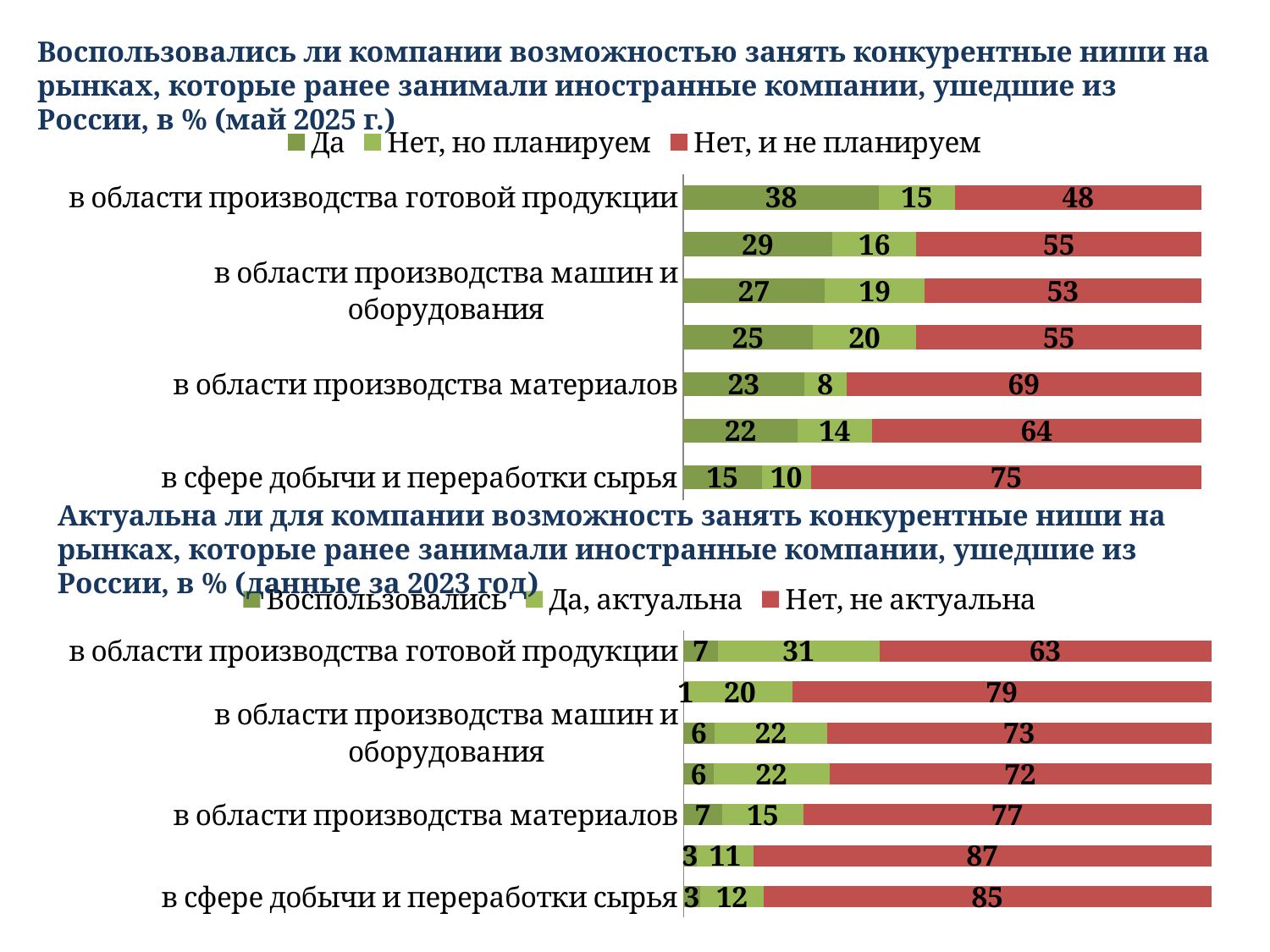
In the top chart (май 2025 г.), what is the value of "Нет, но планируем" for "в области производства материалов"? 8 In the top chart (май 2025 г.), what is the total of the stacked bar for "в области производства материалов"? 100 How many series does the legend of the top chart (май 2025 г.) list? 3 In the top chart (май 2025 г.), what is the value of "Нет, и не планируем" for "в сфере добычи и переработки сырья"? 75 In the bottom chart (данные за 2023 год), which is larger for "Нет, не актуальна": "в области производства материалов" or "в области производства готовой продукции"? в области производства материалов What kind of chart is the top chart (май 2025 г.)? Stacked horizontal bar chart What are the legend entries of the bottom chart (данные за 2023 год)? Воспользовались; Да, актуальна; Нет, не актуальна In the top chart (май 2025 г.), what is the difference between "Нет, и не планируем" and "Да" for "в области производства готовой продукции"? 10 In the top chart (май 2025 г.), which category has the highest value for "Нет, и не планируем"? в сфере добычи и переработки сырья In the top chart (май 2025 г.), what is the value of "Да" for "в области производства готовой продукции"? 38 In the bottom chart (данные за 2023 год), what is the value of "Нет, не актуальна" for "в сфере добычи и переработки сырья"? 85 In the bottom chart (данные за 2023 год), what is the value of "Да, актуальна" for "в области производства готовой продукции"? 31